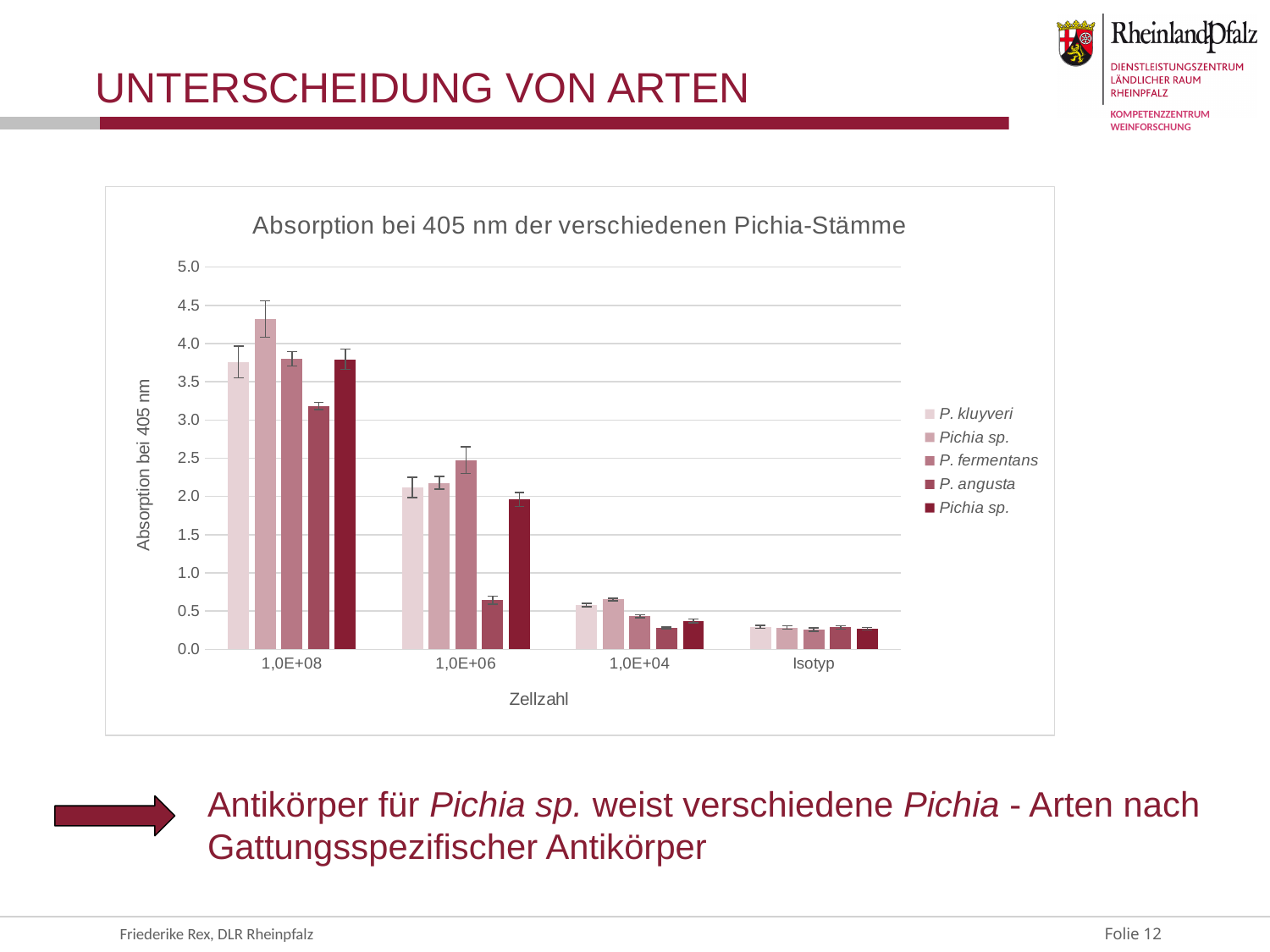
What is the title of the chart? Absorption bei 405 nm der verschiedenen Pichia-Stämme Is the value for P. angusta at 1,0E+08 greater or less than 3.5? less Do the values generally rise or fall moving along the x axis from 1,0E+08 to Isotyp? fall Is the value for P. fermentans at 1,0E+06 greater or less than 2.0? greater How many categories are shown on the x axis of the chart? 4 Which x-axis category has the highest bars in the chart? 1,0E+08 What is the label of the x axis of the chart? Zellzahl Is the value for P. kluyveri at 1,0E+08 greater or less than 3.0? greater How many series does the chart's legend list? 5 Which series has the lowest value at 1,0E+06? P. angusta What kind of chart is shown on the slide? bar chart